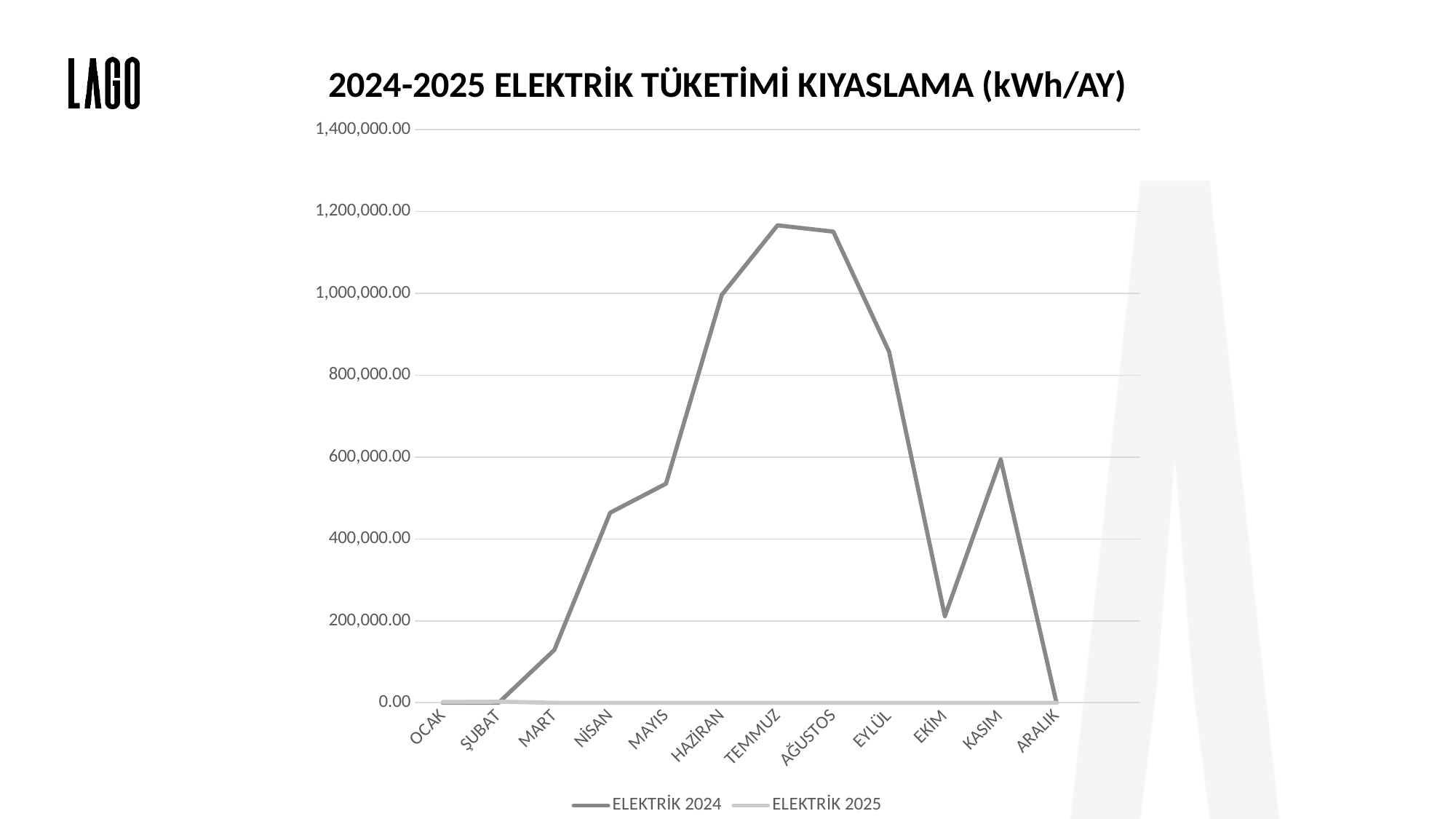
Is the ELEKTRİK 2024 value for MART greater or less than 200,000.00? less What kind of chart is shown on the slide? line chart What is the title of the chart? 2024-2025 ELEKTRİK TÜKETİMİ KIYASLAMA (kWh/AY) For ELEKTRİK 2024, which is larger, the value for TEMMUZ or the value for EKİM? TEMMUZ How many months are shown on the x axis? 12 Is the ELEKTRİK 2024 value for EKİM greater or less than 400,000.00? less Does the ELEKTRİK 2024 line rise or fall from TEMMUZ to EKİM? fall Which series is drawn with the darker line according to the legend? ELEKTRİK 2024 Is the ELEKTRİK 2024 value for KASIM greater or less than 400,000.00? greater How many series does the legend list? 2 For ELEKTRİK 2024, which is larger, the value for HAZİRAN or the value for MAYIS? HAZİRAN